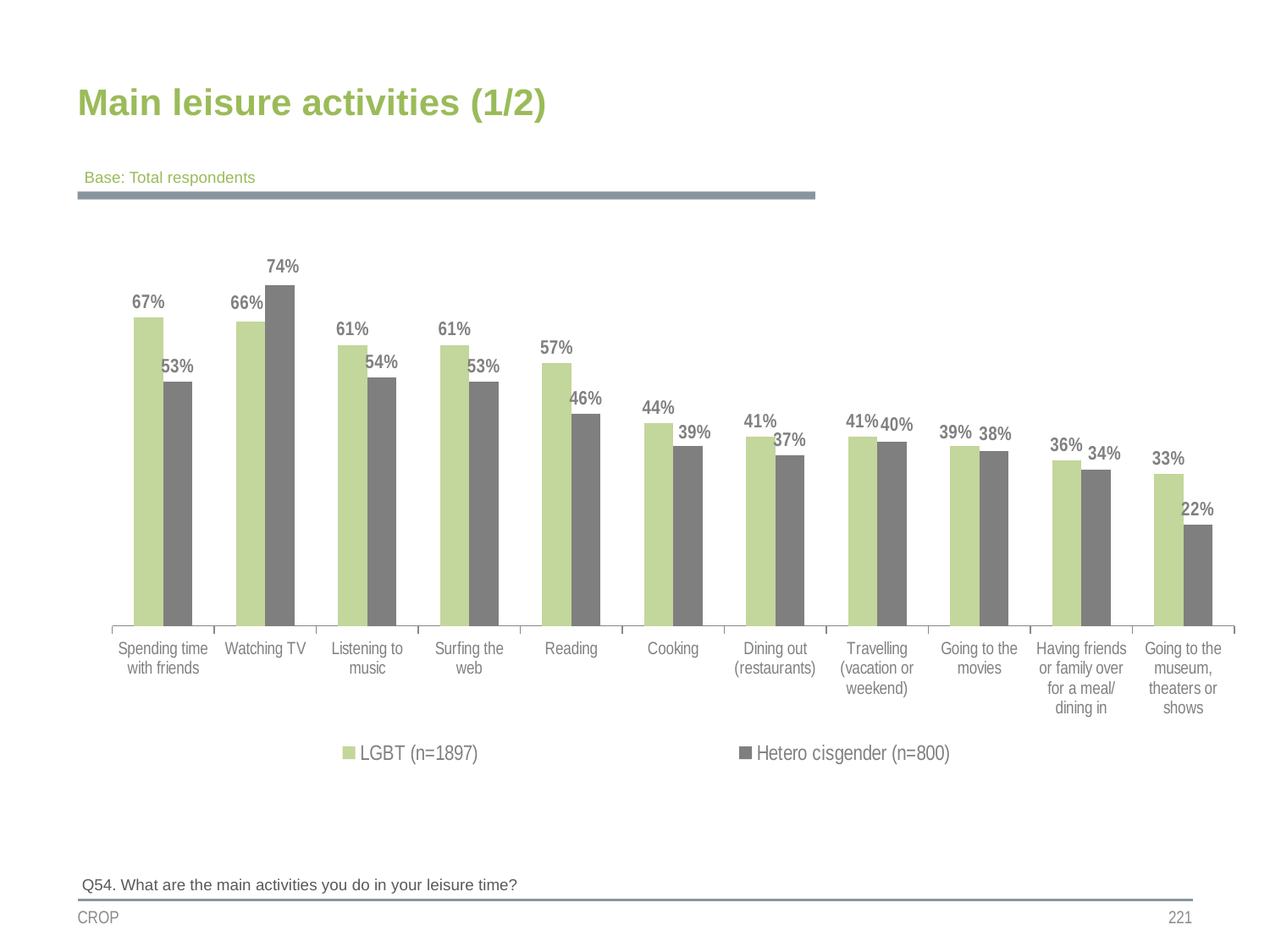
Which is larger for Watching TV: the LGBT value or the Hetero cisgender value? Hetero cisgender What is the difference between the LGBT and Hetero cisgender values for Spending time with friends? 14% What kind of chart is shown on the slide? Bar chart How many activities are shown on the x axis? 11 What is the Hetero cisgender value for Watching TV? 74% Which is larger for Cooking: the LGBT value or the Hetero cisgender value? LGBT How many series does the legend list? 2 What is the Hetero cisgender value for Going to the museum, theaters or shows? 22% Which activity has the highest Hetero cisgender value? Watching TV What is the LGBT value for Spending time with friends? 67% What is the difference between the LGBT and Hetero cisgender values for Reading? 11% Which activity has the lowest LGBT value? Going to the museum, theaters or shows